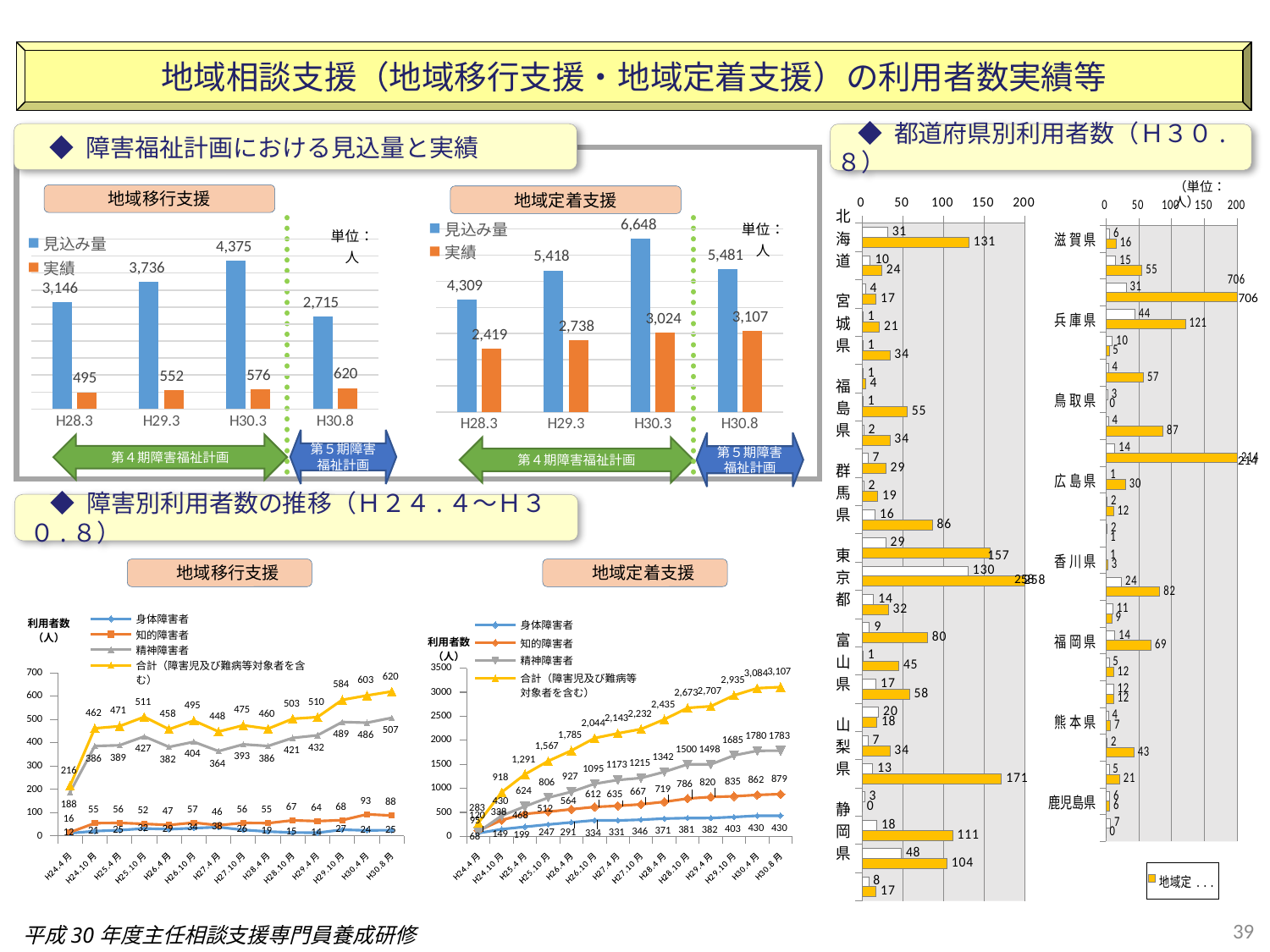
In the 地域移行支援 line chart (bottom left), what is the 合計 value at H24.4? 216 How many periods are shown on the x axis of the 地域移行支援 bar chart (top left)? 4 In the 地域移行支援 bar chart (top left), what is the 見込み量 value for H30.3? 4,375 In the 地域移行支援 bar chart (top left), what is the difference between 見込み量 and 実績 for H28.3? 2,651 In the 地域定着支援 bar chart (top middle), which is larger, the 実績 for H29.3 or for H30.3? H30.3 In the 地域移行支援 bar chart (top left), which period has the lowest 実績? H28.3 What kind of chart is the 地域移行支援 chart at the top left of the slide? bar chart How many series does the legend list in the 地域移行支援 line chart (bottom left)? 4 In the 地域定着支援 line chart (bottom middle), what is the 合計 value at H30.8? 3,107 In the 地域定着支援 line chart (bottom middle), does the 合計 series rise or fall from H24.4 to H30.8? rise In the 地域定着支援 bar chart (top middle), which period has the highest 見込み量? H30.3 In the 地域定着支援 bar chart (top middle), what is the 実績 value for H30.8? 3,107